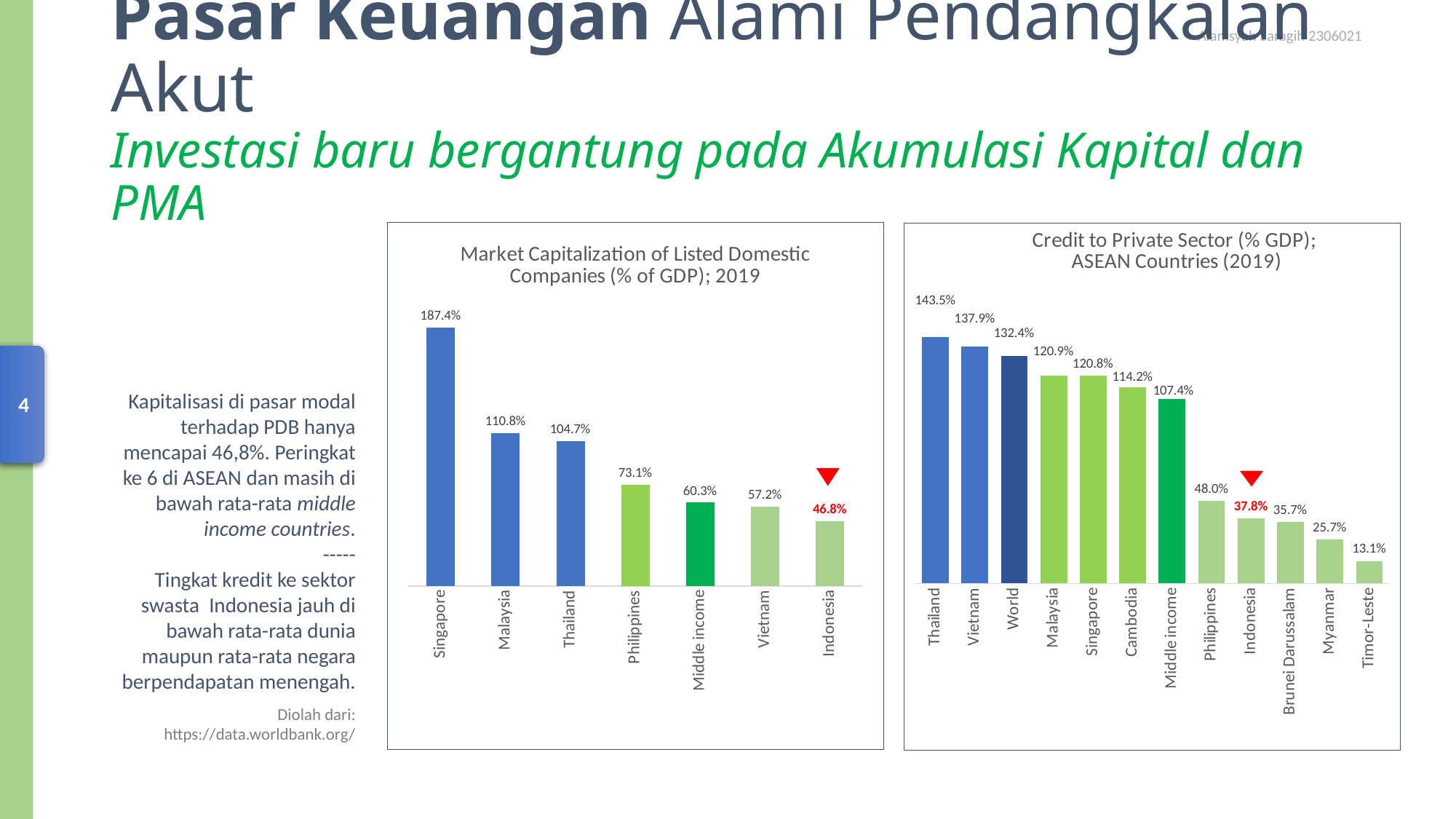
In the Credit to Private Sector chart, which is larger, the value for World or the value for Middle income? World In the Credit to Private Sector chart, what is the value for Thailand? 143.5% In the Credit to Private Sector chart, which category has the lowest value? Timor-Leste In the Market Capitalization of Listed Domestic Companies chart, what is the difference between Malaysia and Thailand? 6.1% In the Market Capitalization of Listed Domestic Companies chart, what is the value for Singapore? 187.4% In the Credit to Private Sector chart, what is the value for Indonesia? 37.8% In the Market Capitalization of Listed Domestic Companies chart, what is the value for Indonesia? 46.8% In the Credit to Private Sector chart, how many categories are shown? 12 In the Market Capitalization of Listed Domestic Companies chart, which category has the lowest value? Indonesia What kind of chart is the Credit to Private Sector chart? Bar chart In the Credit to Private Sector chart, what is the difference between Philippines and Indonesia? 10.2% In the Market Capitalization of Listed Domestic Companies chart, how many categories are shown? 7